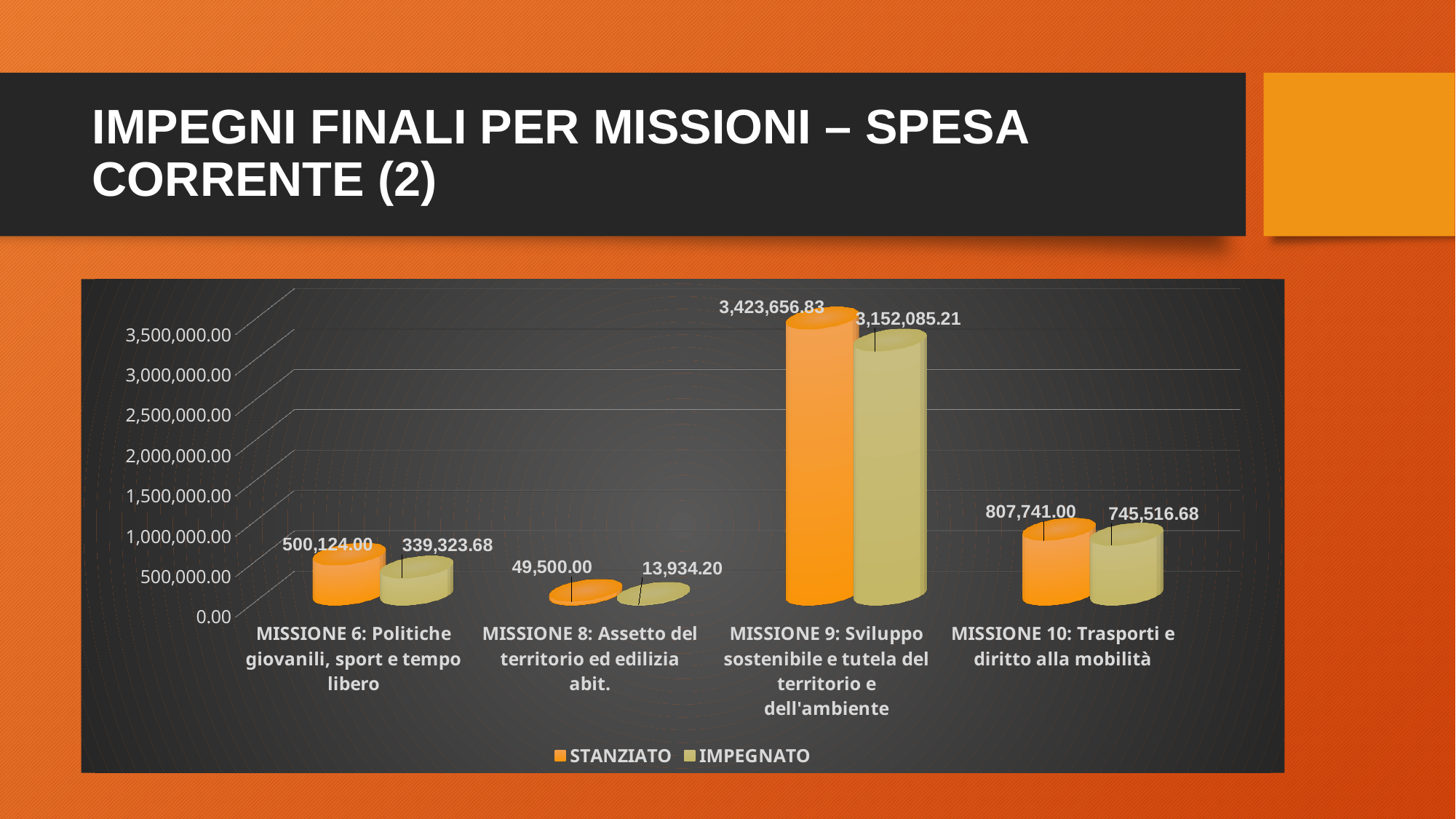
What is the difference between the STANZIATO and IMPEGNATO values for MISSIONE 6? 160,800.32 How many missions (categories) are shown on the x axis? 4 What is the IMPEGNATO value for MISSIONE 6: Politiche giovanili, sport e tempo libero? 339,323.68 Which is larger for MISSIONE 10: the STANZIATO value or the IMPEGNATO value? STANZIATO Which mission has the highest STANZIATO value? MISSIONE 9: Sviluppo sostenibile e tutela del territorio e dell'ambiente What is the IMPEGNATO value for MISSIONE 8: Assetto del territorio ed edilizia abit.? 13,934.20 What is the STANZIATO value for MISSIONE 10: Trasporti e diritto alla mobilità? 807,741.00 What is the STANZIATO value for MISSIONE 9: Sviluppo sostenibile e tutela del territorio e dell'ambiente? 3,423,656.83 What is the difference between the STANZIATO and IMPEGNATO values for MISSIONE 9? 271,571.62 What kind of chart is shown on the slide? Bar chart Which mission has the lowest IMPEGNATO value? MISSIONE 8: Assetto del territorio ed edilizia abit. How many series does the legend list? 2